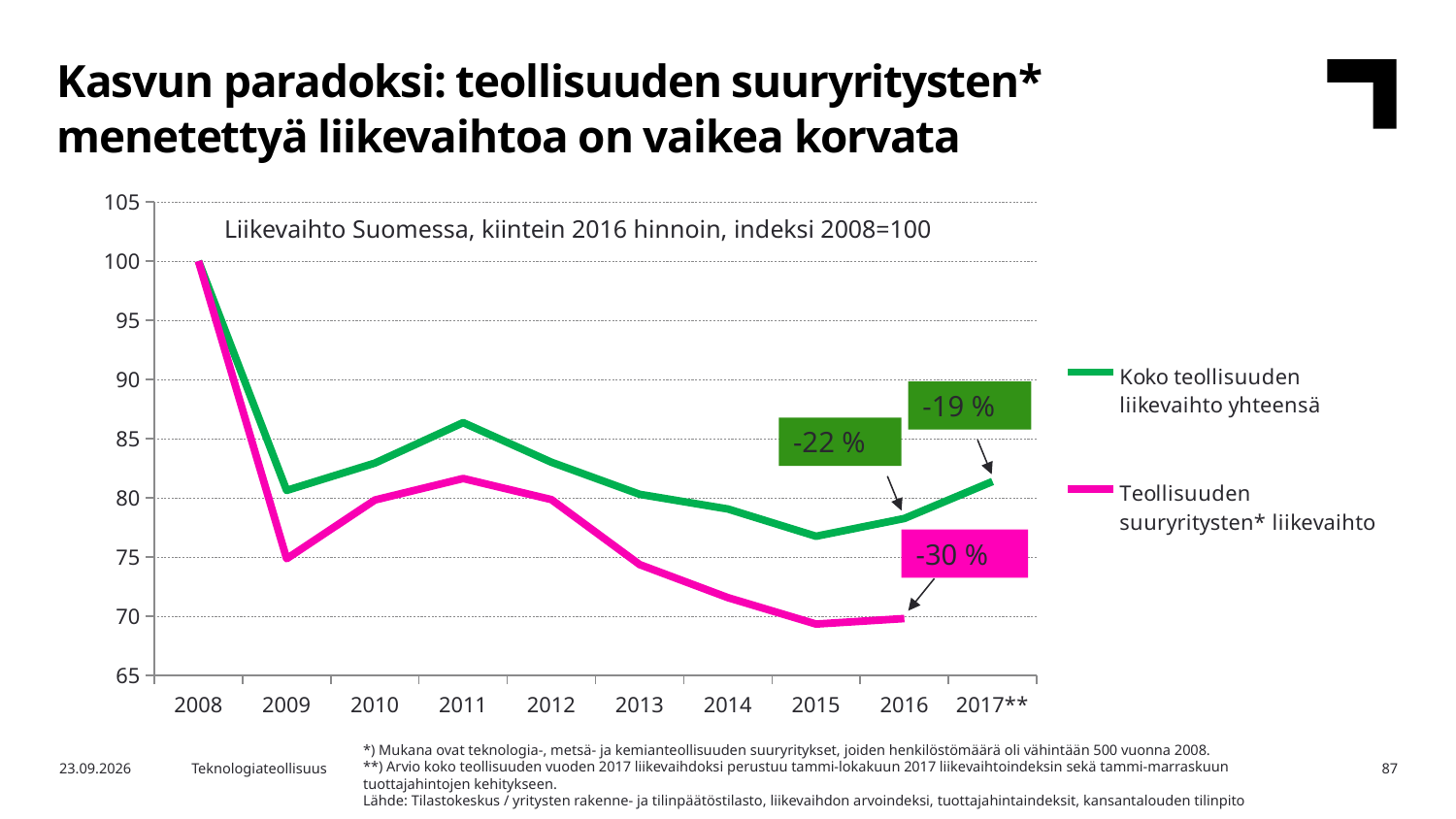
How many series does the legend list? 2 What is the title shown inside the chart area? Liikevaihto Suomessa, kiintein 2016 hinnoin, indeksi 2008=100 What percentage change is labelled on the Teollisuuden suuryritysten* liikevaihto line at 2016? -30 % What kind of chart is shown on the slide? line chart What percentage change is labelled on the Koko teollisuuden liikevaihto yhteensä line at 2017**? -19 % Is the value for Koko teollisuuden liikevaihto yhteensä in 2015 greater or less than 80? less How many years are shown on the x axis? 10 Do the values of both series rise or fall from 2008 to 2009? fall In 2011, which series has the higher value: Koko teollisuuden liikevaihto yhteensä or Teollisuuden suuryritysten* liikevaihto? Koko teollisuuden liikevaihto yhteensä What is the index value of both series in 2008? 100 What percentage change is labelled on the Koko teollisuuden liikevaihto yhteensä line at 2016? -22 % Is the value for Teollisuuden suuryritysten* liikevaihto in 2015 greater or less than 75? less